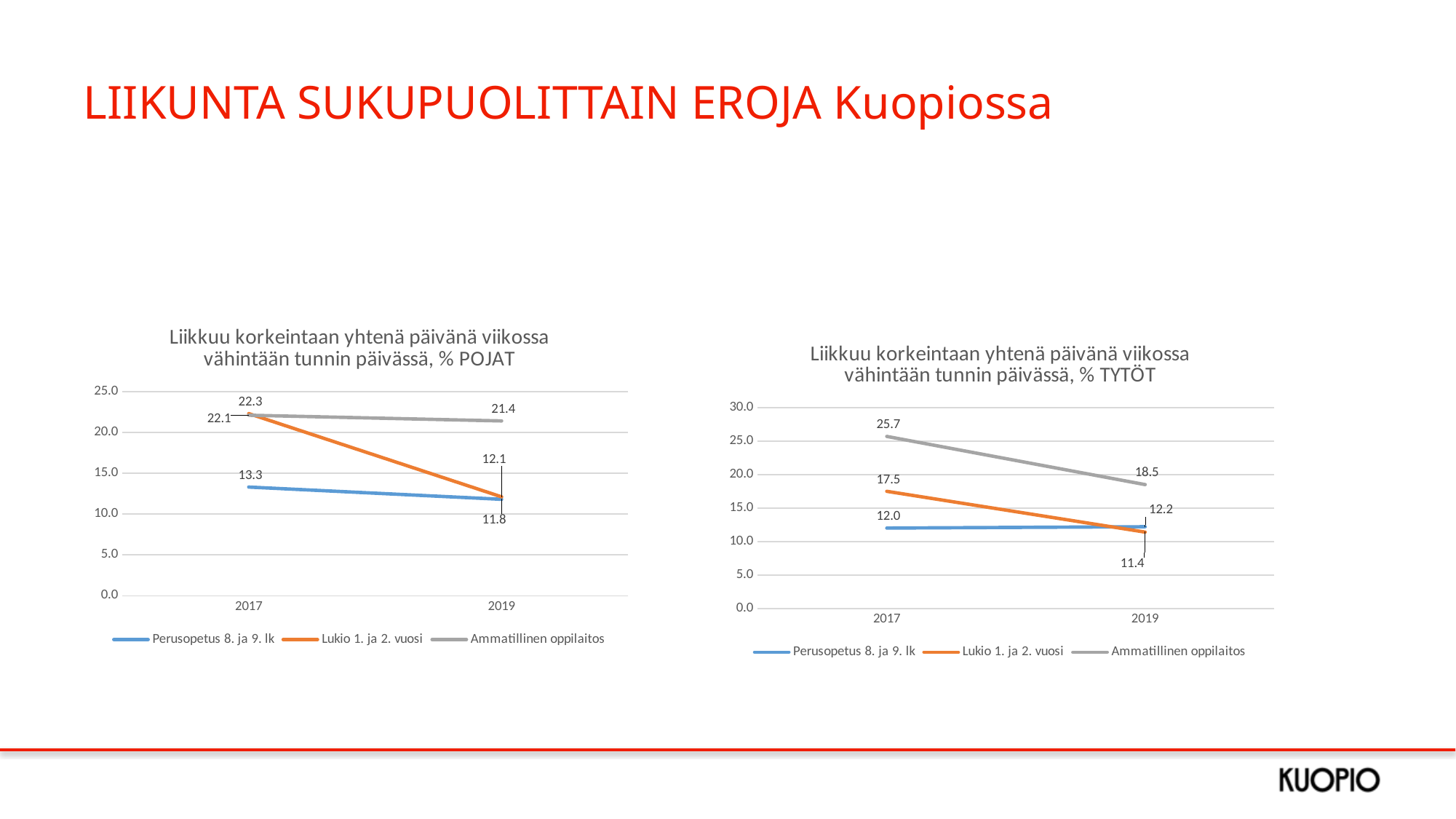
In the POJAT chart on the left, what is the value for Perusopetus 8. ja 9. lk in 2017? 13.3 In the POJAT chart on the left, what is the value for Ammatillinen oppilaitos in 2019? 21.4 How many series does the legend of the TYTÖT chart on the right list? 3 In the TYTÖT chart on the right, which series has the highest value in 2017? Ammatillinen oppilaitos In the TYTÖT chart on the right, by how much did the value for Ammatillinen oppilaitos fall from 2017 to 2019? 7.2 In the chart titled 'Liikkuu korkeintaan yhtenä päivänä viikossa vähintään tunnin päivässä, % TYTÖT', what is the value for Ammatillinen oppilaitos in 2017? 25.7 How many years are shown on the x axis of the POJAT chart on the left? 2 In the TYTÖT chart on the right, which is larger in 2017: Lukio 1. ja 2. vuosi or Perusopetus 8. ja 9. lk? Lukio 1. ja 2. vuosi In the TYTÖT chart on the right, what is the difference between the Lukio 1. ja 2. vuosi values in 2017 and 2019? 6.1 What type of chart is used in the POJAT chart on the left? Line chart In the TYTÖT chart on the right, does the value for Ammatillinen oppilaitos rise or fall from 2017 to 2019? Fall In the TYTÖT chart on the right, what is the value for Lukio 1. ja 2. vuosi in 2019? 11.4